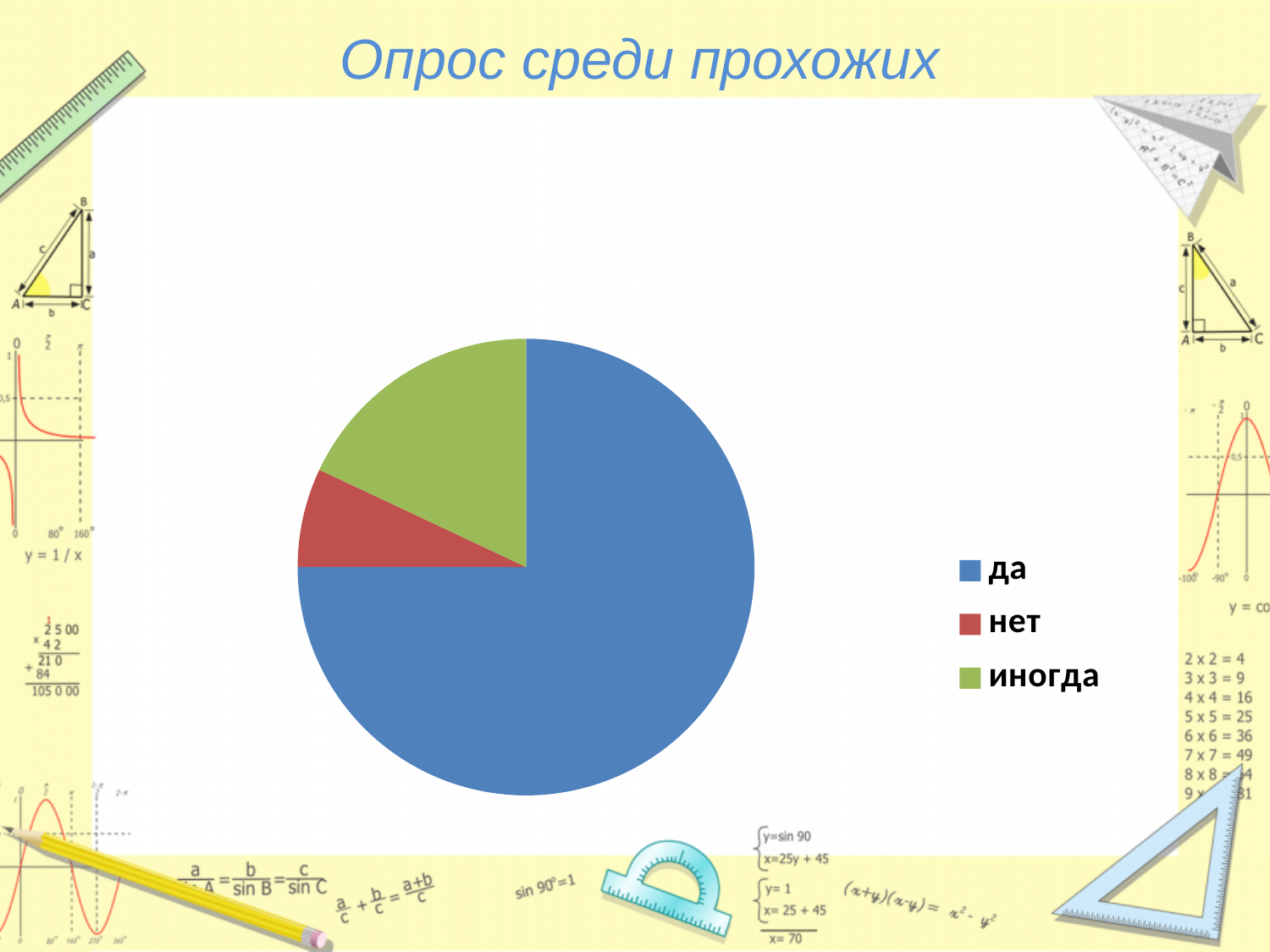
How many slices does the pie chart have? 3 What colour is the slice for "нет"? red How many entries does the legend list? 3 What kind of chart is shown on the slide? pie chart Does the "да" slice take up more or less than half of the pie? more What is the title of the chart on the slide? Опрос среди прохожих Which category has the smallest slice of the pie? нет Which slice is larger, "иногда" or "нет"? иногда Which slice is larger, "да" or "иногда"? да Which category has the largest slice of the pie? да